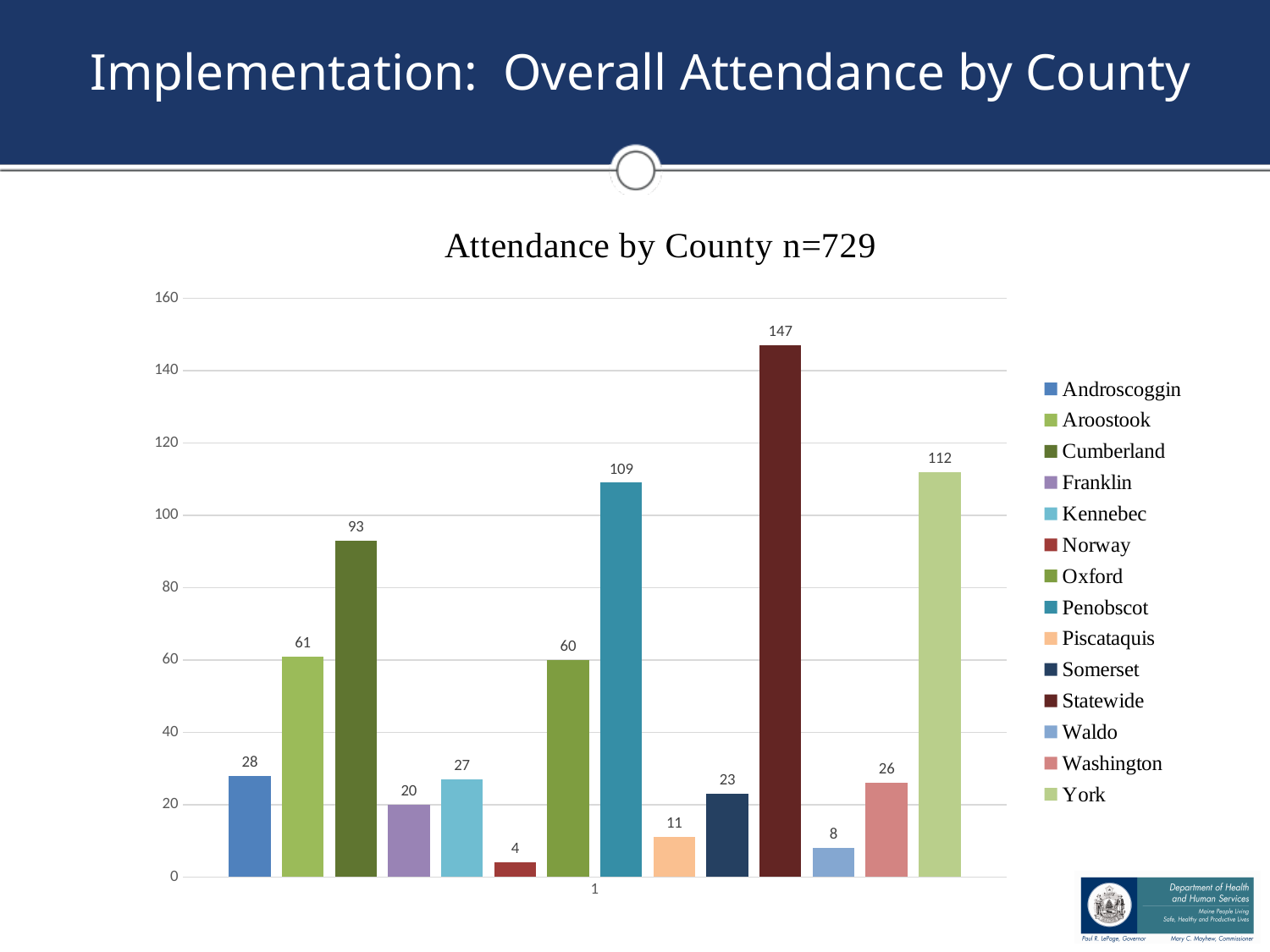
What is the attendance value for Piscataquis? 11 How many series does the legend list? 14 What is the attendance value for Penobscot? 109 What is the title of the chart? Attendance by County n=729 Which is larger, the value for Androscoggin or the value for Kennebec? Androscoggin Is the value for Statewide greater or less than 140? greater What kind of chart is shown on the slide? bar chart What is the attendance value for Cumberland? 93 What is the difference between the York value and the Aroostook value? 51 How many bars are plotted in the chart? 14 Which legend entry has the lowest bar? Norway Which legend entry has the highest bar? Statewide